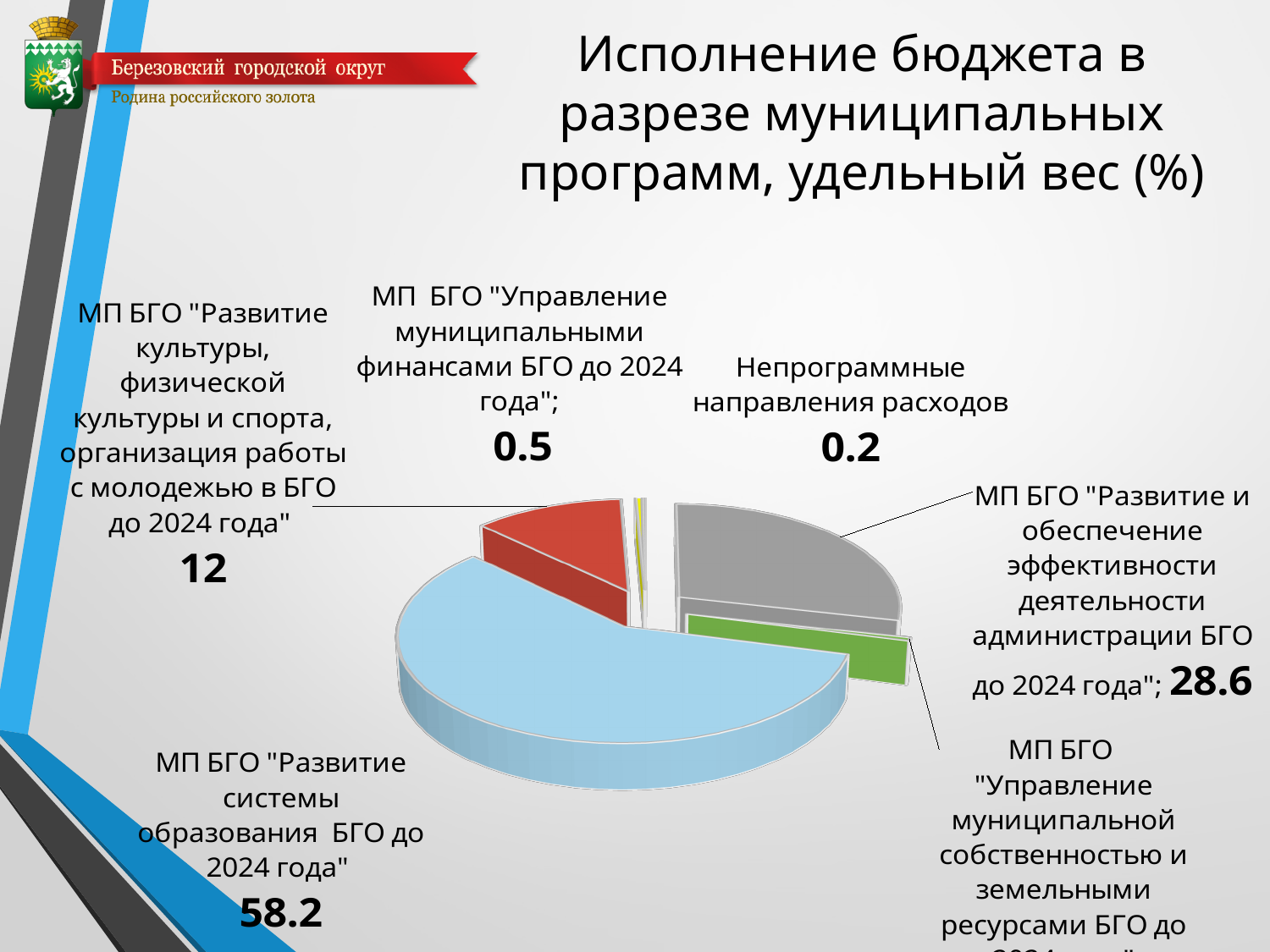
What is the share for МП БГО "Управление муниципальными финансами БГО до 2024 года"? 0.5 What is the share for МП БГО "Развитие культуры, физической культуры и спорта, организация работы с молодежью в БГО до 2024 года"? 12 What type of chart is shown on the slide? Pie chart What is the share for МП БГО "Развитие и обеспечение эффективности деятельности администрации БГО до 2024 года"? 28.6 What is the difference between the shares for the education programme (58.2) and the administration programme (28.6)? 29.6 What is the title of the chart on the slide? Исполнение бюджета в разрезе муниципальных программ, удельный вес (%) What is the share for МП БГО "Развитие системы образования БГО до 2024 года"? 58.2 What is the difference between the shares for the administration programme (28.6) and the culture and sport programme (12)? 16.6 Which category has the largest share of the pie? МП БГО "Развитие системы образования БГО до 2024 года" What is the share for Непрограммные направления расходов? 0.2 How many categories (slices) are shown in the pie chart? 6 Which has the smaller share: Непрограммные направления расходов or МП БГО "Управление муниципальными финансами БГО до 2024 года"? Непрограммные направления расходов